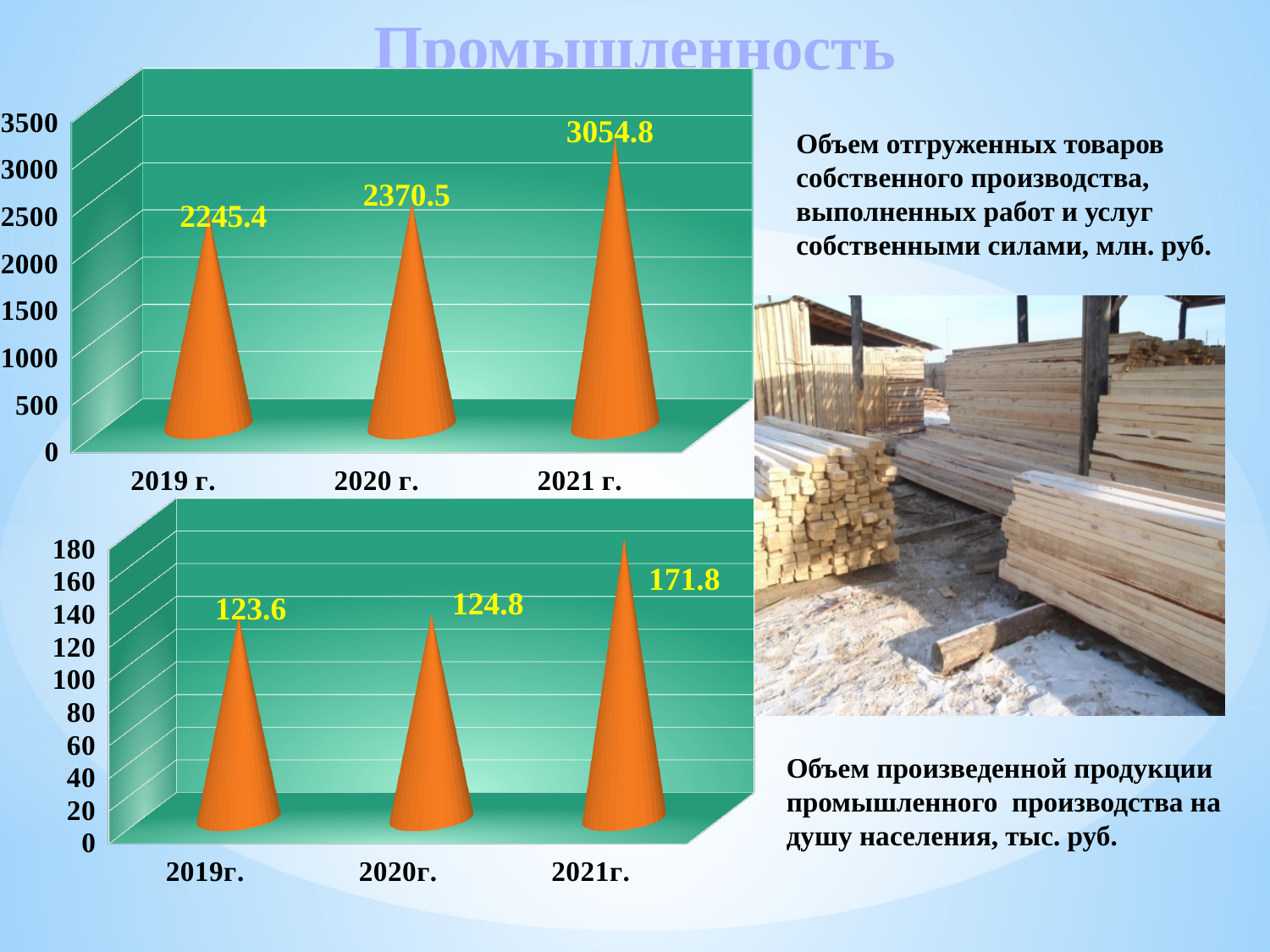
In the top chart, is the value for 2020 г. greater or less than 2500? less In the bottom chart, what is the value for 2020г.? 124.8 In the bottom chart, what is the value for 2021г.? 171.8 Do the values in the top chart rise or fall from 2019 г. to 2021 г.? rise How many years are shown in the bottom chart? 3 In the top chart, what is the value for 2021 г.? 3054.8 In the top chart, which is larger, the value for 2020 г. or the value for 2021 г.? 2021 г. In the bottom chart, what is the difference between the values for 2021г. and 2020г.? 47.0 In the top chart, which year has the highest value? 2021 г. In the top chart, what is the difference between the values for 2021 г. and 2019 г.? 809.4 In the top chart, what is the value for 2019 г.? 2245.4 In the bottom chart, which year has the lowest value? 2019г.